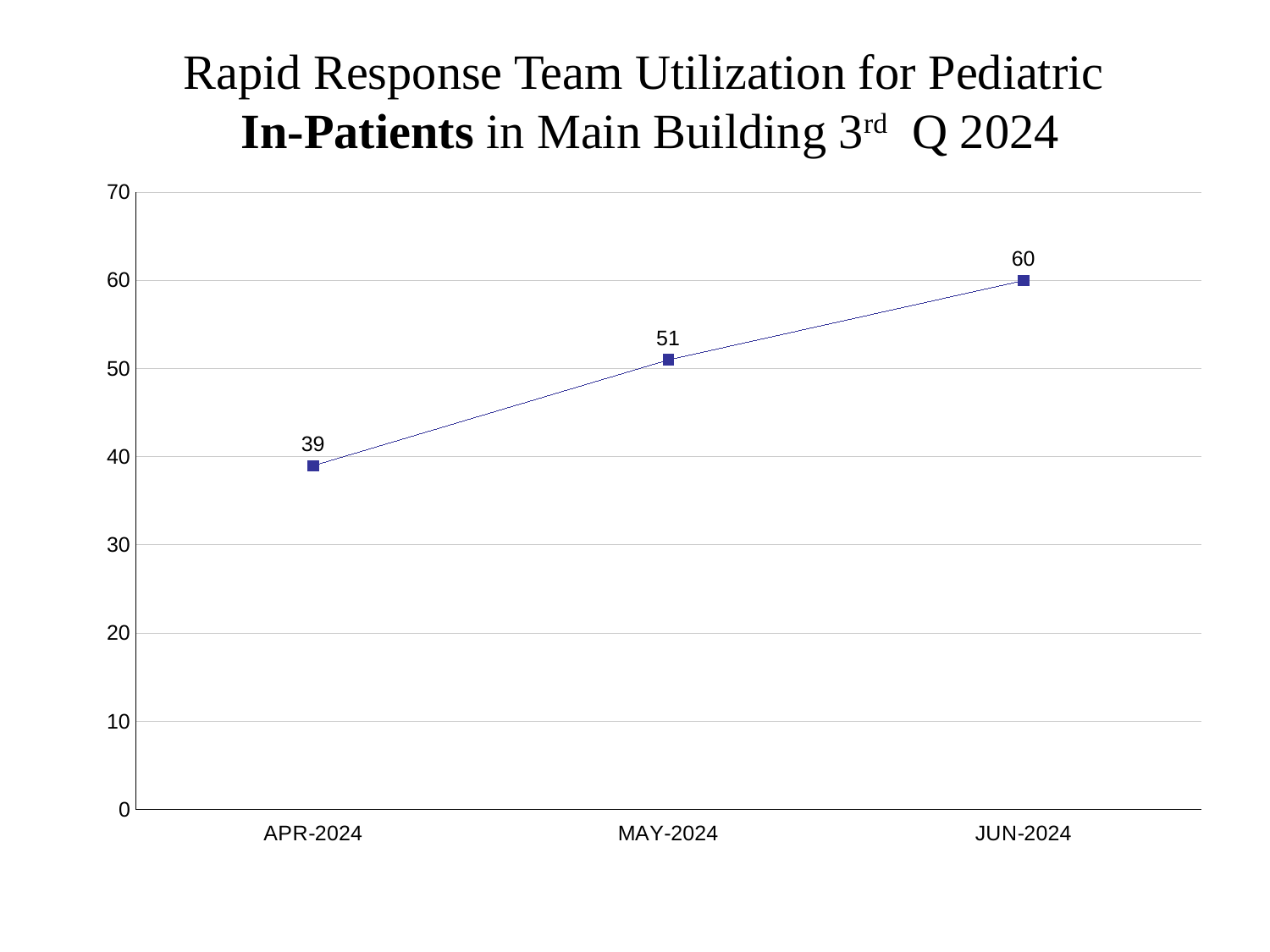
How many months are plotted on the chart? 3 Is the value for APR-2024 greater or less than 40? less What is the difference between the values for MAY-2024 and APR-2024? 12 Which month has the highest value? JUN-2024 Which month has the lowest value? APR-2024 What kind of chart is shown on the slide? line chart Do the values rise or fall from APR-2024 to JUN-2024? rise What is the value for MAY-2024? 51 What is the value for JUN-2024? 60 What is the value for APR-2024? 39 Which is larger, the value for MAY-2024 or the value for JUN-2024? JUN-2024 What is the difference between the values for JUN-2024 and APR-2024? 21